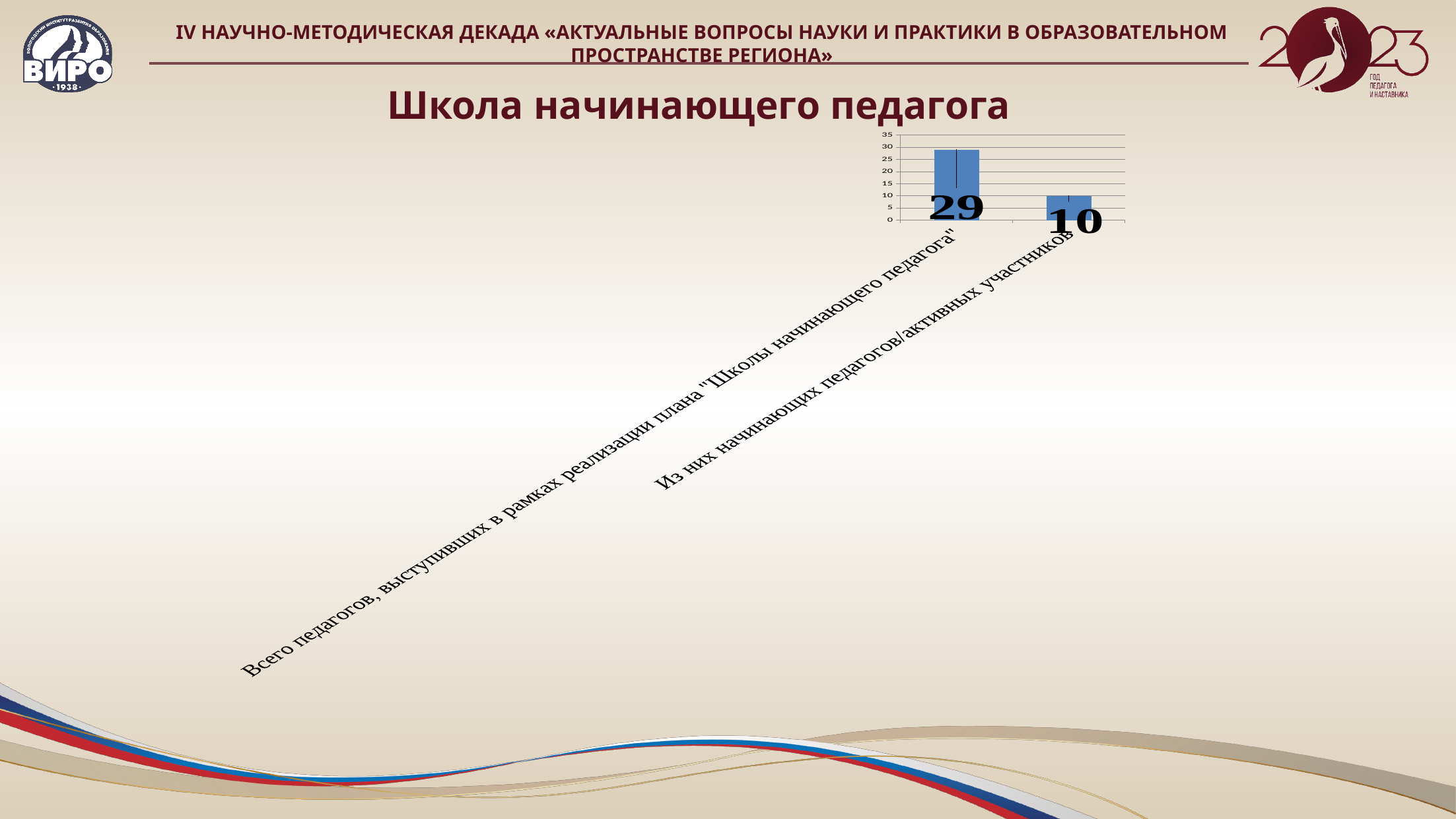
What kind of chart is shown on the slide? bar chart Which is larger: the value for "Всего педагогов, выступивших в рамках реализации плана "Школы начинающего педагога"" or the value for "Из них начинающих педагогов/активных участников"? Всего педагогов, выступивших в рамках реализации плана "Школы начинающего педагога" What is the difference between the value for "Всего педагогов, выступивших в рамках реализации плана "Школы начинающего педагога"" and the value for "Из них начинающих педагогов/активных участников"? 19 What is the value for "Всего педагогов, выступивших в рамках реализации плана "Школы начинающего педагога""? 29 Which category has the lowest value? Из них начинающих педагогов/активных участников Which category has the highest value? Всего педагогов, выступивших в рамках реализации плана "Школы начинающего педагога" Is the value for "Всего педагогов, выступивших в рамках реализации плана "Школы начинающего педагога"" greater or less than 25? greater Do the values rise or fall from the first category to the second? fall Is the value for "Из них начинающих педагогов/активных участников" greater or less than 15? less What is the value for "Из них начинающих педагогов/активных участников"? 10 What is the highest value shown on the vertical axis of the chart? 35 How many categories are shown in the chart? 2